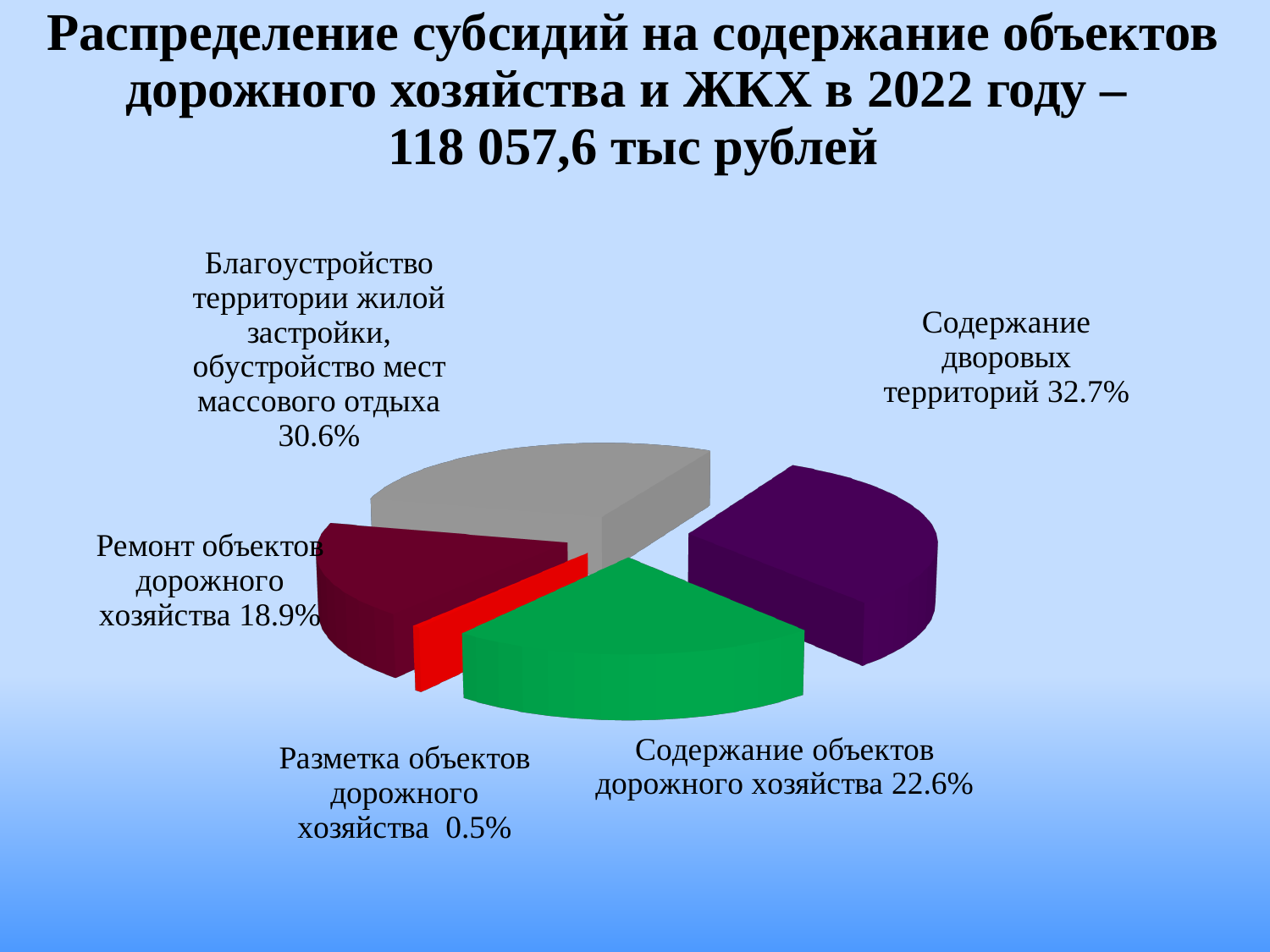
How many slices does the pie chart have? 5 Which category has the largest share of the pie? Содержание дворовых территорий What percentage is shown for "Ремонт объектов дорожного хозяйства"? 18.9% What percentage is shown for "Благоустройство территории жилой застройки, обустройство мест массового отдыха"? 30.6% What is the difference in percentage points between "Содержание объектов дорожного хозяйства" and "Ремонт объектов дорожного хозяйства"? 3.7 What share of the pie does "Содержание дворовых территорий" represent? 32.7% What kind of chart is shown on the slide? Pie chart What percentage is shown for "Содержание объектов дорожного хозяйства"? 22.6% What is the difference in percentage points between "Содержание дворовых территорий" and "Благоустройство территории жилой застройки, обустройство мест массового отдыха"? 2.1 Which is larger: the share for "Содержание объектов дорожного хозяйства" or for "Ремонт объектов дорожного хозяйства"? Содержание объектов дорожного хозяйства Which category is shown by the green slice? Содержание объектов дорожного хозяйства Which category has the smallest share of the pie? Разметка объектов дорожного хозяйства